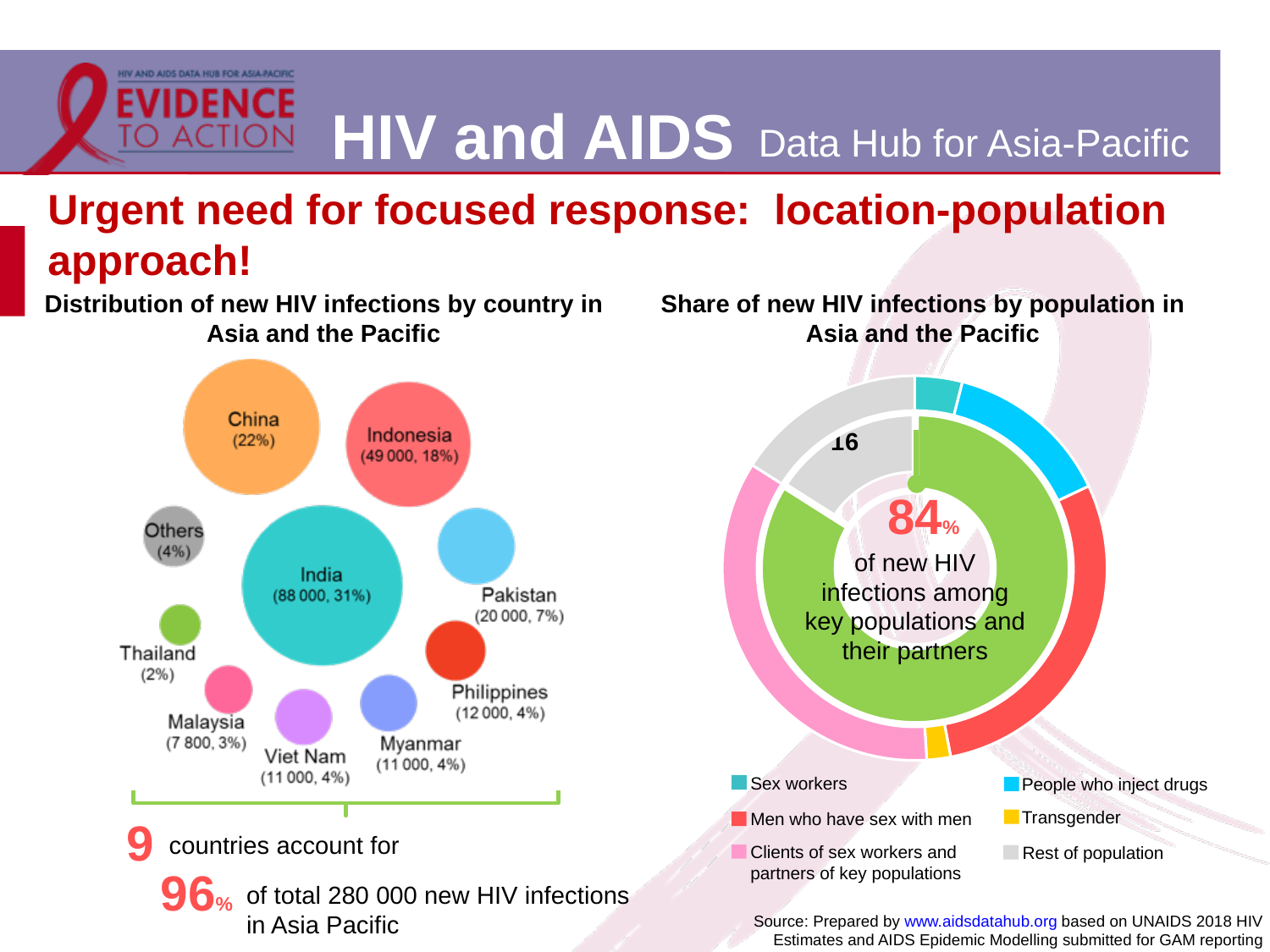
In the 'Distribution of new HIV infections by country in Asia and the Pacific' chart, which has more new HIV infections, Pakistan or the Philippines? Pakistan In the 'Distribution of new HIV infections by country in Asia and the Pacific' chart, how many new HIV infections are shown for Indonesia? 49 000 In the 'Distribution of new HIV infections by country in Asia and the Pacific' chart, what share of new HIV infections does India account for? 31% What type of chart is the 'Share of new HIV infections by population in Asia and the Pacific' chart? Donut chart In the 'Distribution of new HIV infections by country in Asia and the Pacific' chart, which named country has the smallest share of new HIV infections? Thailand In the 'Distribution of new HIV infections by country in Asia and the Pacific' chart, how many new HIV infections are shown for Malaysia? 7 800 How many bubbles (countries plus 'Others') are shown in the 'Distribution of new HIV infections by country in Asia and the Pacific' chart? 10 In the 'Distribution of new HIV infections by country in Asia and the Pacific' chart, what percentage is shown for China? 22% In the 'Distribution of new HIV infections by country in Asia and the Pacific' chart, what is the difference in new HIV infections between India and Indonesia? 39 000 In the 'Share of new HIV infections by population in Asia and the Pacific' chart, what percentage of new HIV infections is among key populations and their partners? 84% In the 'Distribution of new HIV infections by country in Asia and the Pacific' chart, which country has the largest share of new HIV infections? India How many population groups does the legend of the 'Share of new HIV infections by population in Asia and the Pacific' chart list? 6